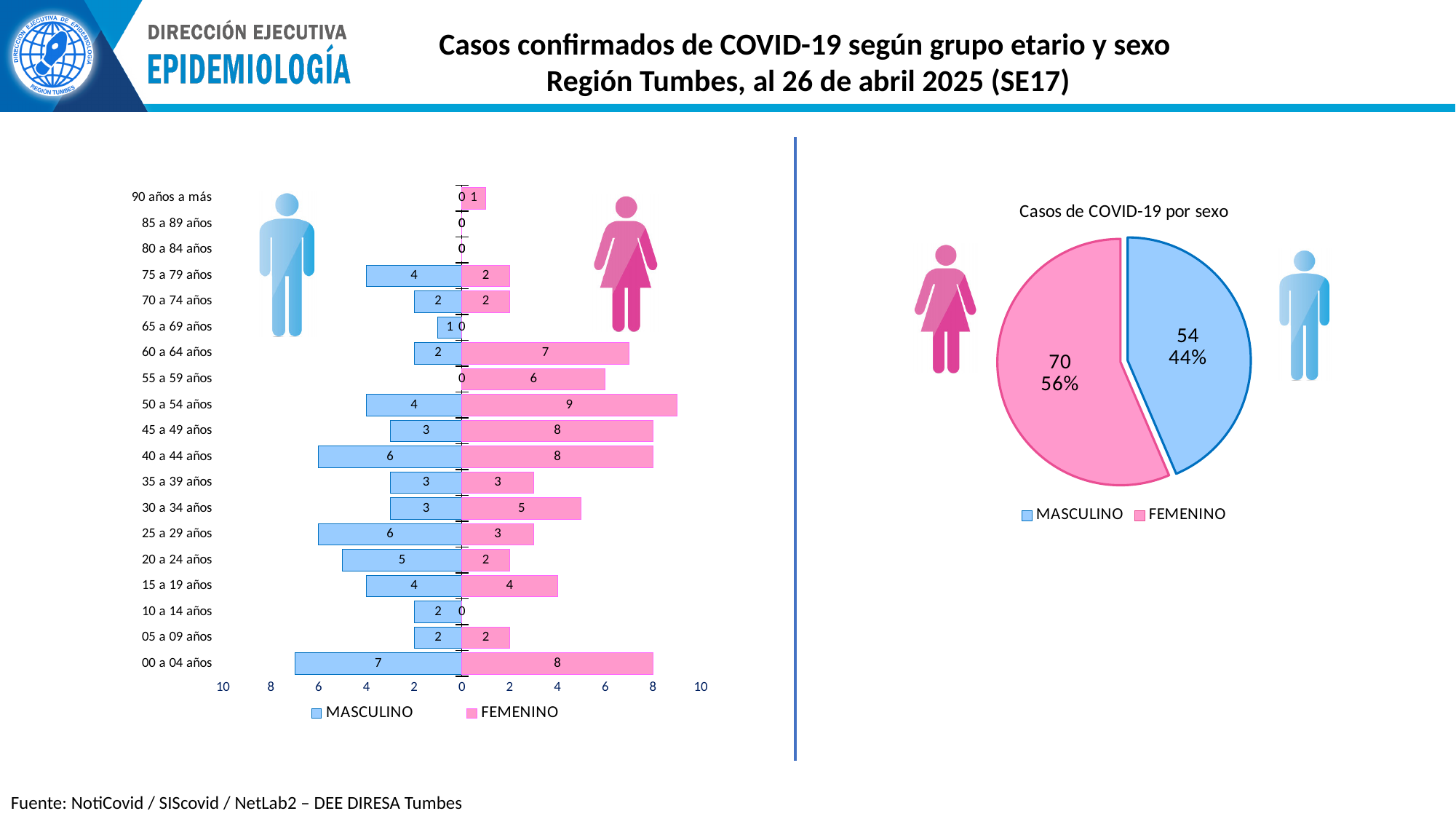
In the pie chart 'Casos de COVID-19 por sexo', what share of cases is MASCULINO? 44% How many series does the legend of the left bar chart list? 2 In the pie chart 'Casos de COVID-19 por sexo', what is the value for FEMENINO? 70 How many age groups are shown in the left bar chart? 19 In the left bar chart, which age group has the highest FEMENINO value? 50 a 54 años What is the title of the pie chart on the right of the slide? Casos de COVID-19 por sexo In the left bar chart, which is larger for 25 a 29 años, MASCULINO or FEMENINO? MASCULINO In the left bar chart, what is the difference between the FEMENINO and MASCULINO values for 50 a 54 años? 5 In the left bar chart, which age group has the highest MASCULINO value? 00 a 04 años What kind of chart is the chart on the left of the slide? Bar chart In the left bar chart, how many MASCULINO cases are in the 00 a 04 años group? 7 In the left bar chart, how many FEMENINO cases are in the 60 a 64 años group? 7